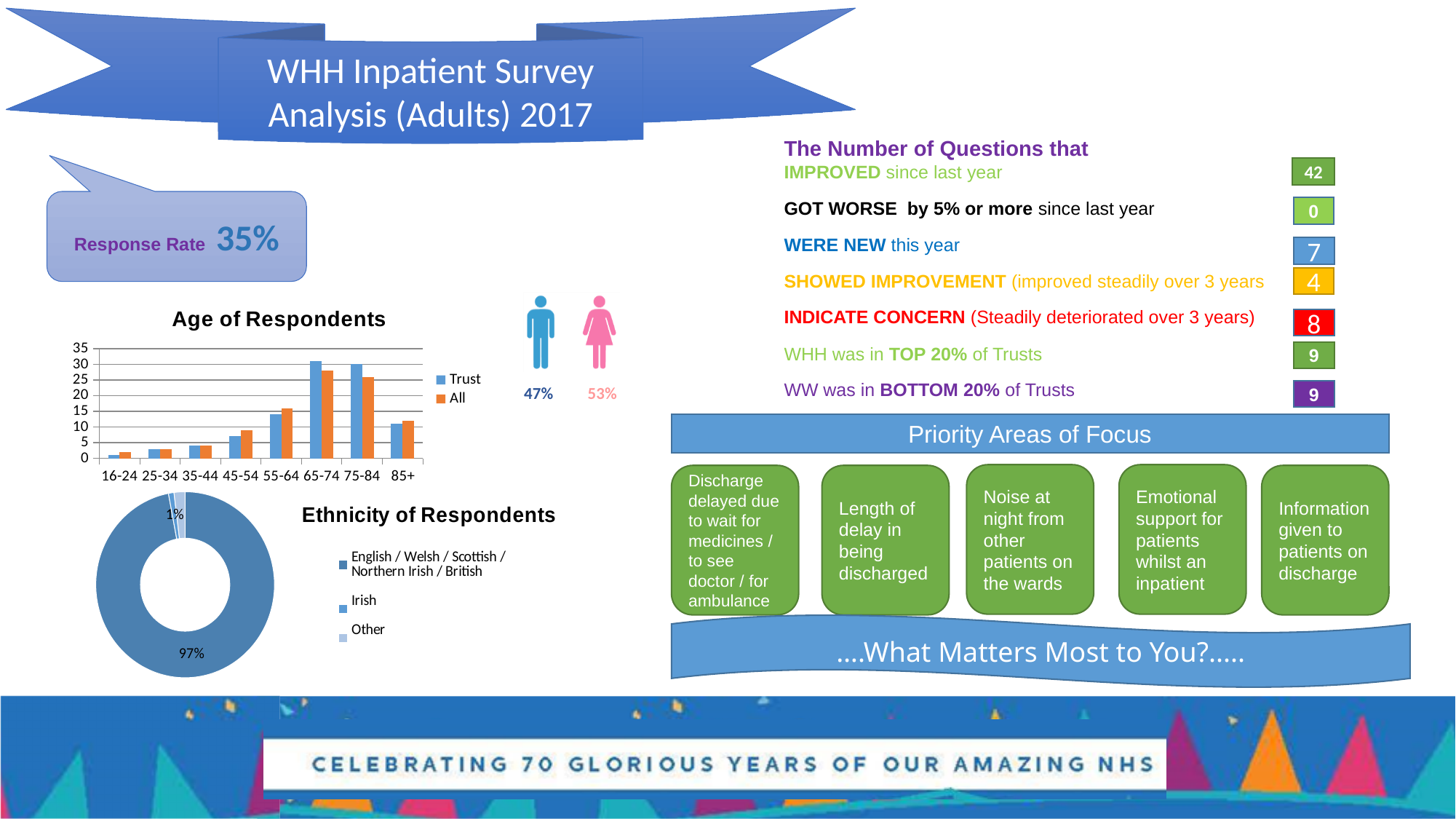
In the 'Age of Respondents' chart, which is larger for the 65-74 group, Trust or All? Trust What type of chart is the 'Ethnicity of Respondents' chart? doughnut chart How many categories does the legend of the 'Ethnicity of Respondents' chart list? 3 In the 'Age of Respondents' chart, which age group has the highest Trust value? 65-74 In the 'Age of Respondents' chart, is the Trust value for 45-54 greater or less than 10? less How many age categories are shown on the x axis of the 'Age of Respondents' chart? 8 In the 'Age of Respondents' chart, is the All value for 65-74 greater or less than 30? less In the 'Ethnicity of Respondents' chart, what share of respondents are English / Welsh / Scottish / Northern Irish / British? 97% How many series does the legend of the 'Age of Respondents' chart list? 2 What type of chart is the 'Age of Respondents' chart? bar chart In the 'Age of Respondents' chart, which age group has the lowest Trust value? 16-24 In the 'Age of Respondents' chart, which is larger for the 55-64 group, Trust or All? All